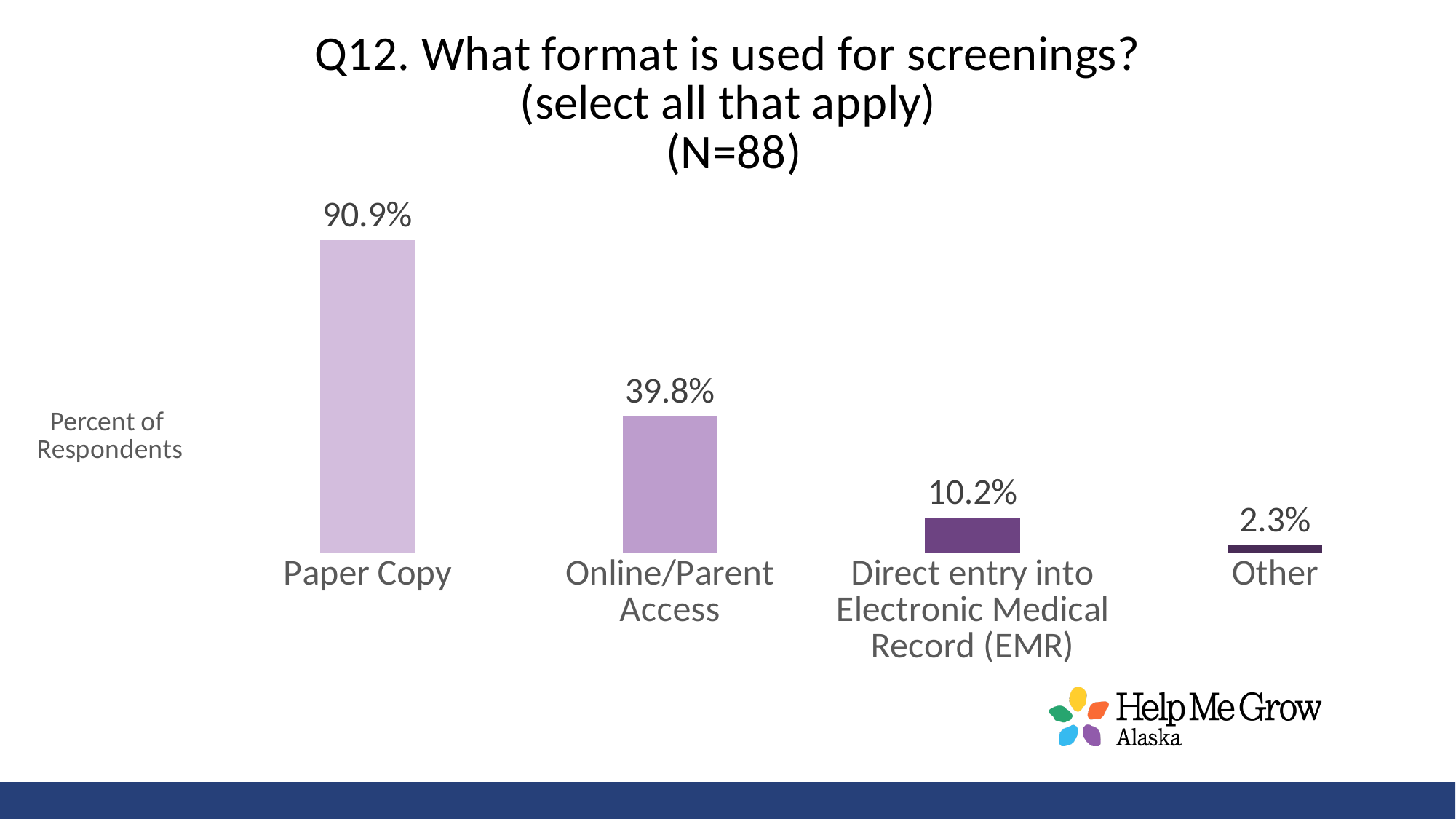
What is the difference between the Direct entry into Electronic Medical Record (EMR) and Other values? 7.9% What percentage of respondents use Paper Copy for screenings? 90.9% Which format has the lowest percentage of respondents? Other What is the value for Online/Parent Access? 39.8% How many categories are shown in the chart? 4 Which is larger, the value for Online/Parent Access or the value for Direct entry into Electronic Medical Record (EMR)? Online/Parent Access Which format has the highest percentage of respondents? Paper Copy What is the sample size (N) stated in the chart title? 88 What is the difference between the Paper Copy and Online/Parent Access values? 51.1% What is the value for Other? 2.3% What kind of chart is shown on the slide? Bar chart What percentage of respondents use Direct entry into Electronic Medical Record (EMR)? 10.2%